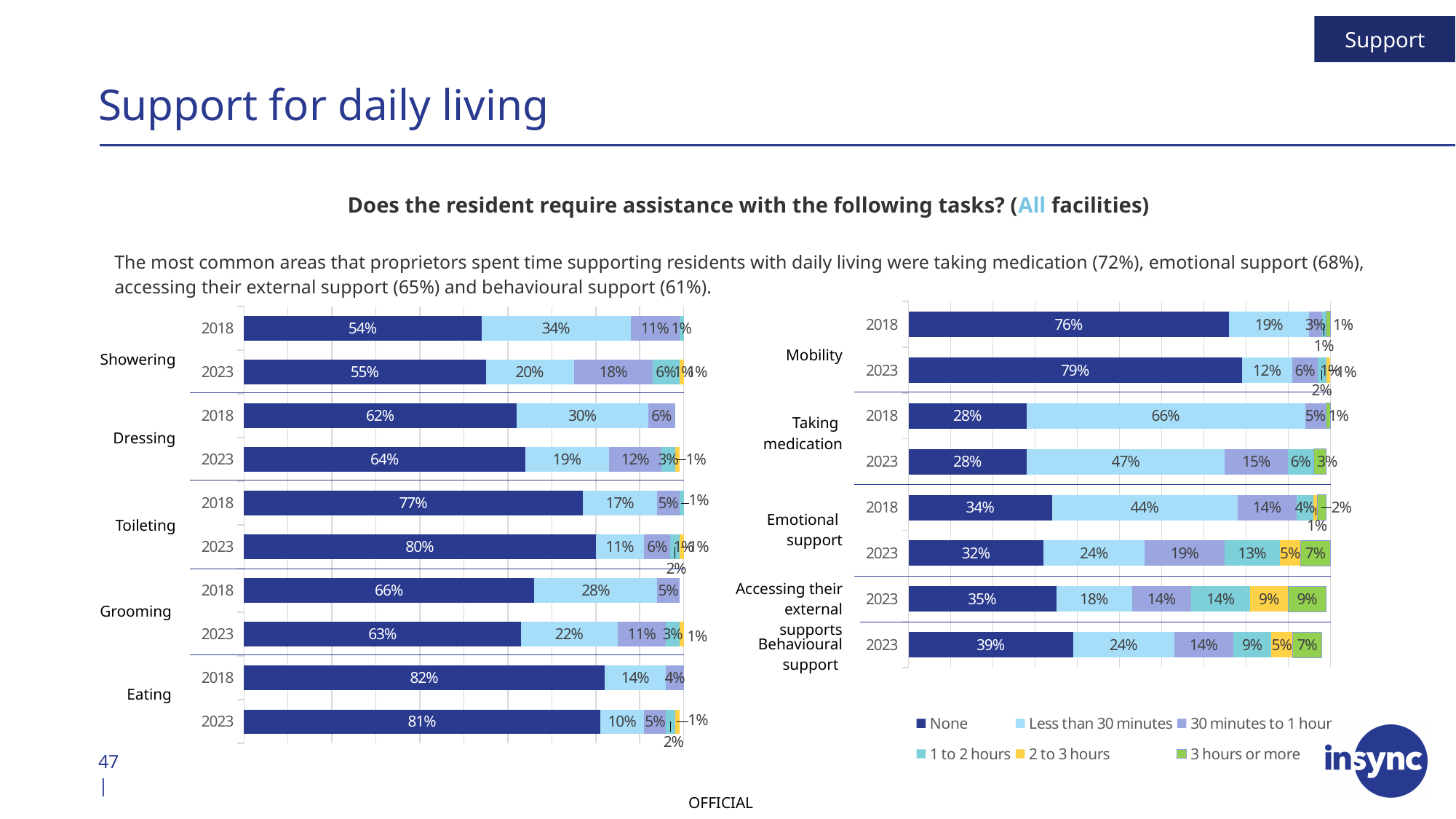
In the left chart, which task had the highest 'None' percentage in 2018? Eating In the left chart, what percentage of residents required no assistance (None) with Showering in 2023? 55% In the right chart, what is the '3 hours or more' value for Behavioural support in 2023? 7% In the right chart, what is the 'Less than 30 minutes' value for Taking medication in 2023? 47% In the left chart, which is larger for 2018: the 'Less than 30 minutes' value for Showering or for Dressing? Showering How many series does the legend list? 6 What kind of chart is used on this slide? Stacked bar chart In the right chart, which task had the lowest 'None' percentage in 2023? Taking medication In the left chart, did the 'None' value for Toileting rise or fall from 2018 to 2023? Rise In the right chart, by how many percentage points did the 'None' value for Mobility change from 2018 to 2023? 3 percentage points In the right chart, what is the '30 minutes to 1 hour' value for Emotional support in 2023? 19% How many tasks are shown in the left chart? 5